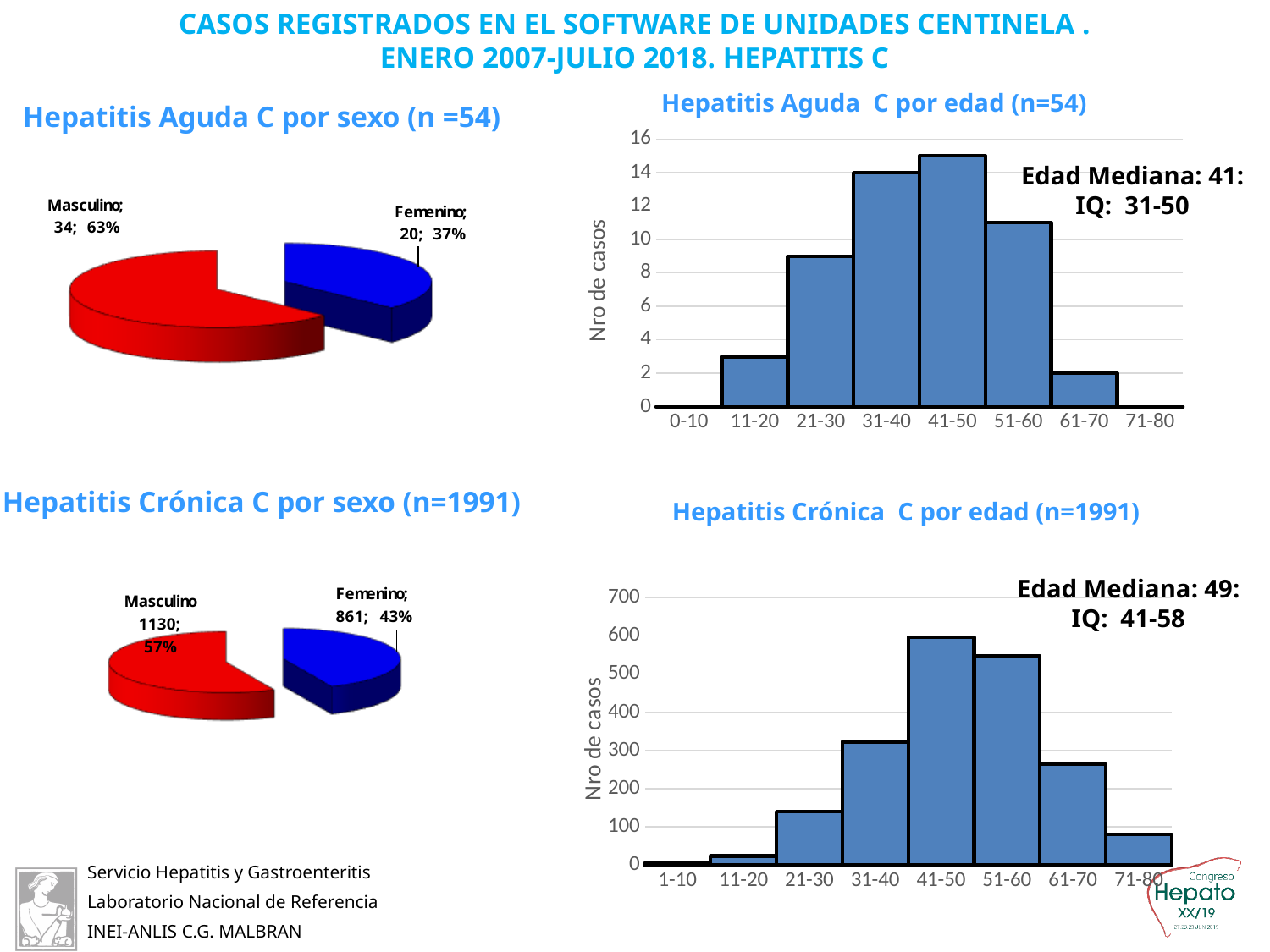
In the 'Hepatitis Crónica C por edad (n=1991)' chart, is the value for the 31-40 age group greater or less than 400? less In the 'Hepatitis Crónica C por sexo (n=1991)' pie chart, what percentage of cases are Masculino? 57% In the 'Hepatitis Crónica C por edad (n=1991)' chart, which has more cases, the 51-60 or the 61-70 age group? 51-60 In the 'Hepatitis Crónica C por edad (n=1991)' chart, which age group has the highest number of cases? 41-50 In the 'Hepatitis Crónica C por sexo (n=1991)' pie chart, how many cases are Femenino? 861 In the 'Hepatitis Aguda C por edad (n=54)' chart, which age group has the highest number of cases? 41-50 In the 'Hepatitis Aguda C por edad (n=54)' chart, what is the number of cases for the 31-40 age group? 14 In the 'Hepatitis Aguda C por sexo (n =54)' pie chart, what percentage of cases are Femenino? 37% In the 'Hepatitis Crónica C por sexo (n=1991)' pie chart, what is the difference between the Masculino and Femenino case counts? 269 In the 'Hepatitis Aguda C por edad (n=54)' chart, is the value for the 21-30 age group greater or less than 8? greater What kind of chart is 'Hepatitis Crónica C por edad (n=1991)'? Bar chart In the 'Hepatitis Aguda C por sexo (n =54)' pie chart, how many cases are Masculino? 34